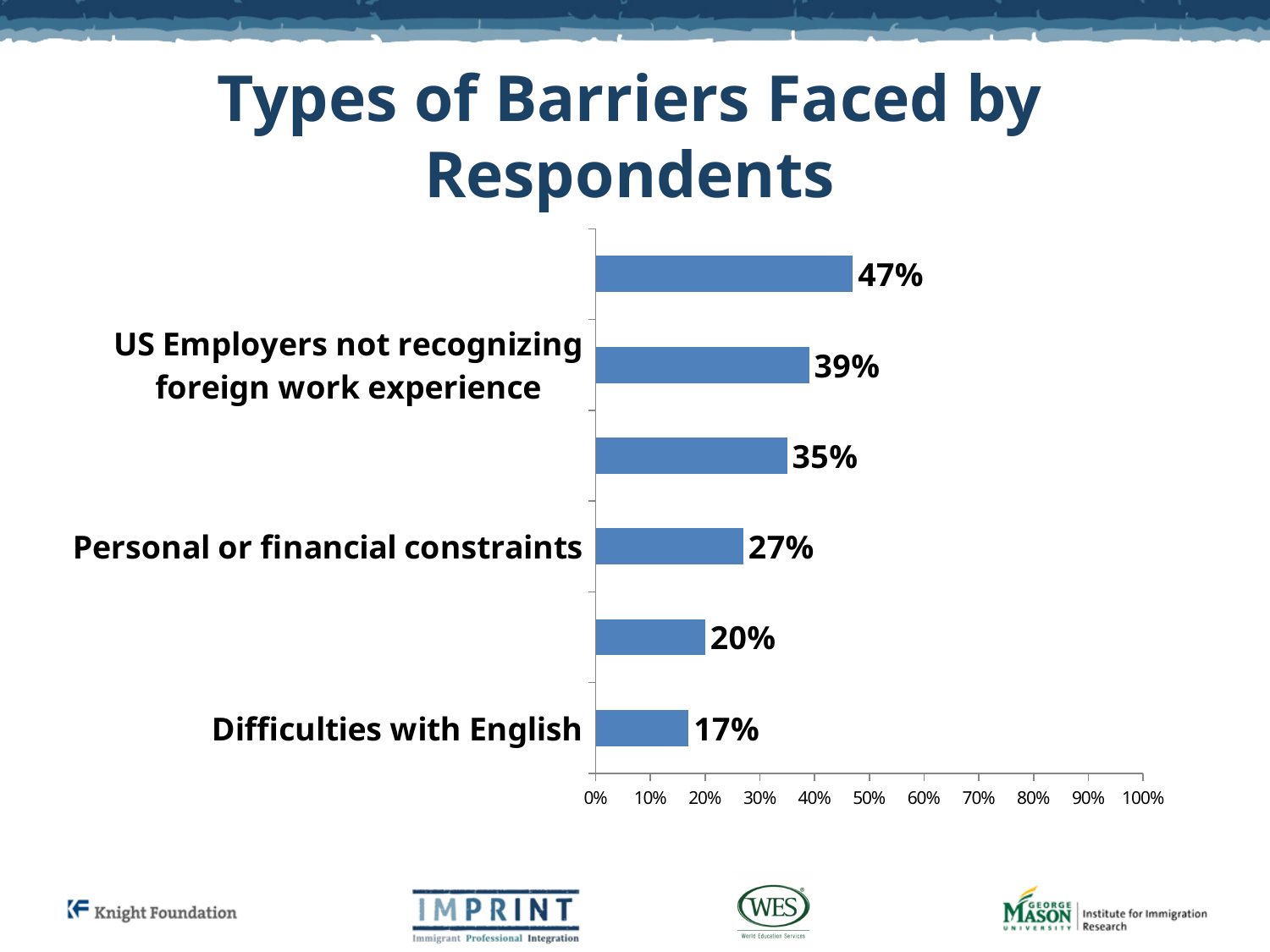
What is the difference in percentage points between US Employers not recognizing foreign work experience and Personal or financial constraints? 12 percentage points What is the value shown for Personal or financial constraints? 27% What percentage of respondents reported US Employers not recognizing foreign work experience as a barrier? 39% Which is larger: the value for Personal or financial constraints or the value for Difficulties with English? Personal or financial constraints What is the highest value shown on any bar in the chart? 47% What is the difference in percentage points between Personal or financial constraints and Difficulties with English? 10 percentage points Is the value for Personal or financial constraints greater or less than 30%? less Which labeled barrier has the lowest value on the chart? Difficulties with English What kind of chart is shown on the slide? Bar chart What percentage is shown for Difficulties with English? 17% What is the title of the chart on the slide? Types of Barriers Faced by Respondents How many bars are plotted in the chart? 6